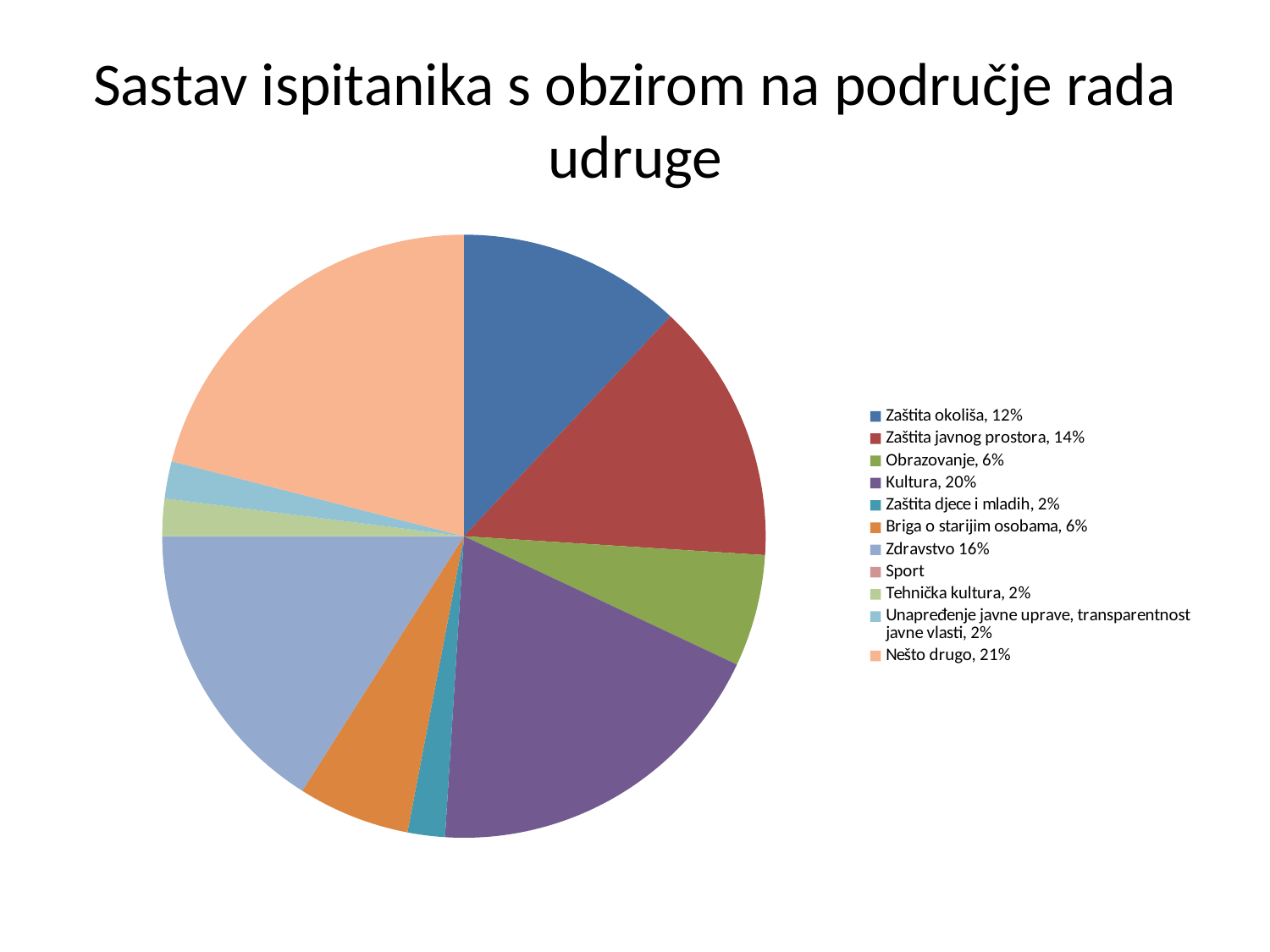
What is the title of the chart? Sastav ispitanika s obzirom na područje rada udruge What share of the pie does Kultura have? 20% What is the difference in percentage points between Nešto drugo and Zaštita okoliša? 9 Which is larger, the share for Zdravstvo or the share for Zaštita javnog prostora? Zdravstvo What percentage is shown for Zdravstvo? 16% What percentage is shown for Zaštita javnog prostora? 14% What kind of chart is shown on the slide? pie chart Which category has the largest share of the pie? Nešto drugo What percentage is shown for Briga o starijim osobama? 6% What is the combined share of Obrazovanje and Briga o starijim osobama? 12% What percentage is shown for Tehnička kultura? 2% How many categories does the legend list? 11